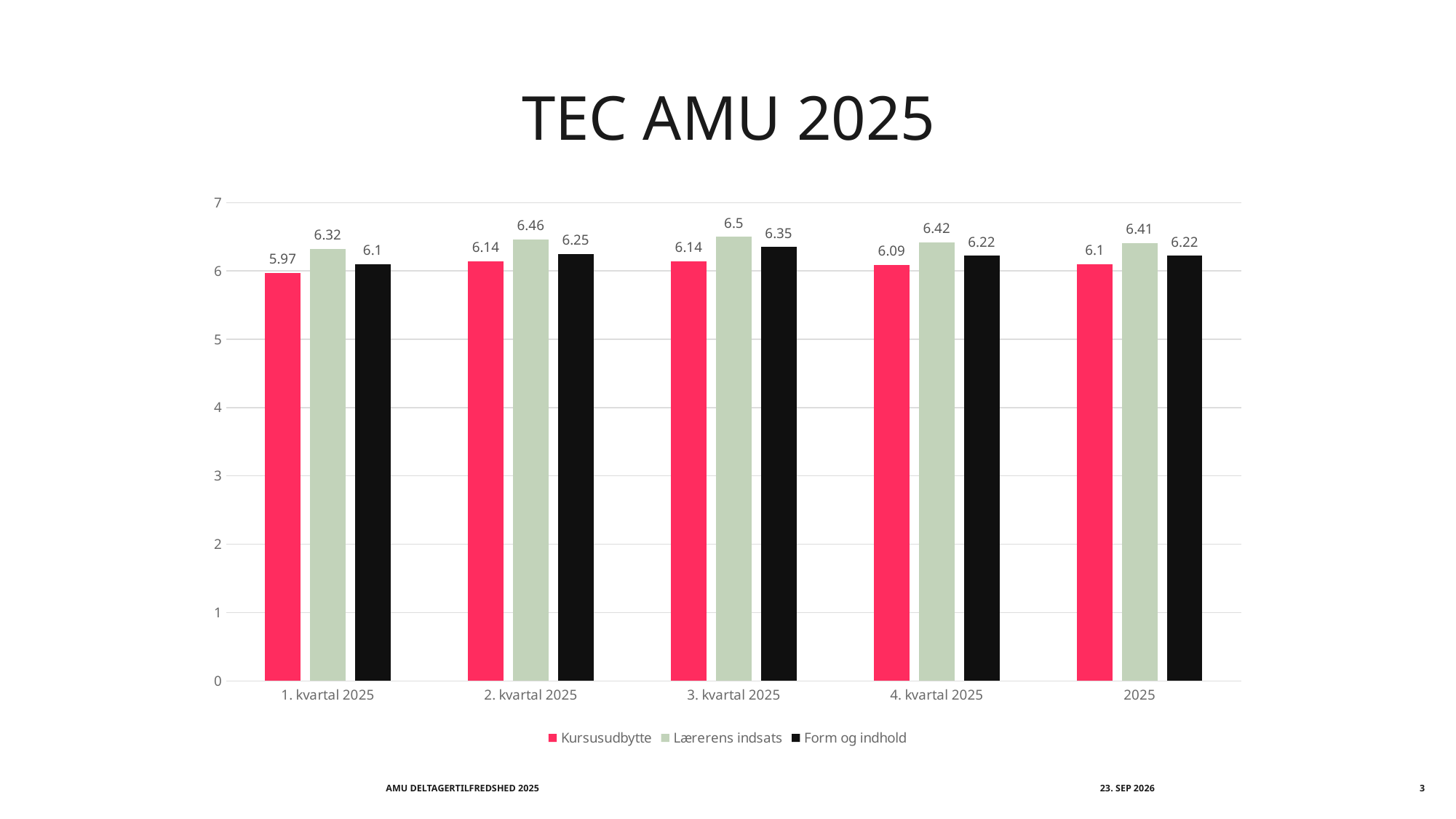
What kind of chart is shown on the slide? Bar chart In which category is Kursusudbytte lowest? 1. kvartal 2025 In which category does Lærerens indsats reach its highest value? 3. kvartal 2025 How many series does the legend list? 3 Which is larger in 1. kvartal 2025: Form og indhold or Kursusudbytte? Form og indhold What is the difference between Lærerens indsats and Kursusudbytte in 4. kvartal 2025? 0.33 What is the value of Form og indhold for 2. kvartal 2025? 6.25 What is the value of Kursusudbytte for 2025? 6.1 What is the value of Lærerens indsats for 3. kvartal 2025? 6.5 What is the title of the chart? TEC AMU 2025 What is the value of Kursusudbytte for 1. kvartal 2025? 5.97 How many categories are shown on the x axis? 5